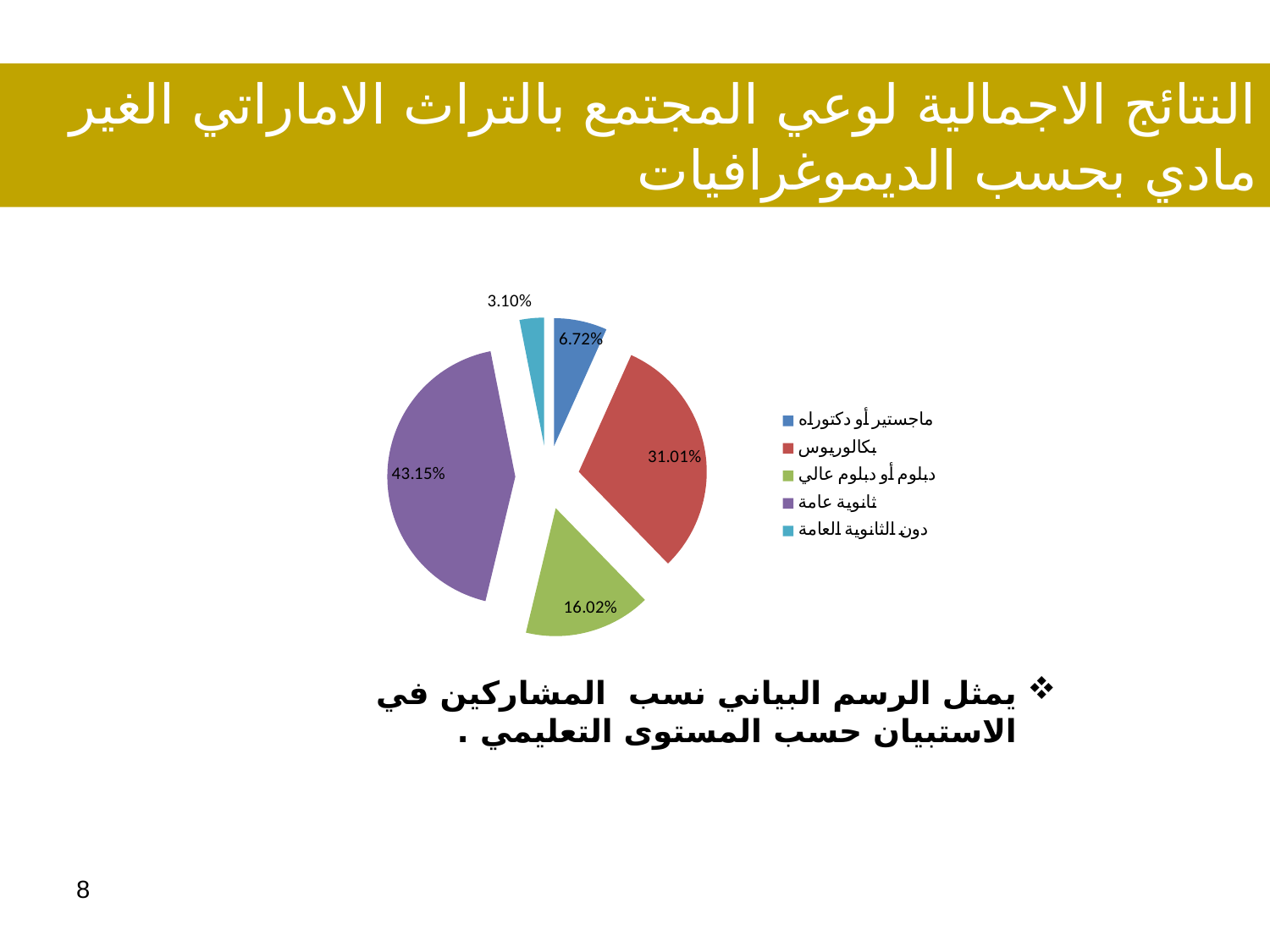
Which is larger: the share for دبلوم أو دبلوم عالي or the share for ماجستير أو دكتوراه? دبلوم أو دبلوم عالي How many education-level categories does the pie chart show? 5 What kind of chart is shown on the slide? pie chart What colour is the slice representing بكالوريوس? red What is the difference in percentage points between the ثانوية عامة slice and the بكالوريوس slice? 12.14 Which education level has the smallest share of participants? دون الثانوية العامة What percentage of participants hold a bachelor's degree (بكالوريوس)? 31.01% What percentage of participants have a diploma or higher diploma (دبلوم أو دبلوم عالي)? 16.02% What percentage of participants have a general secondary education (ثانوية عامة)? 43.15% Which education level has the largest share of participants? ثانوية عامة What percentage of participants have less than general secondary education (دون الثانوية العامة)? 3.10% What percentage of participants hold a master's or doctorate (ماجستير أو دكتوراه)? 6.72%